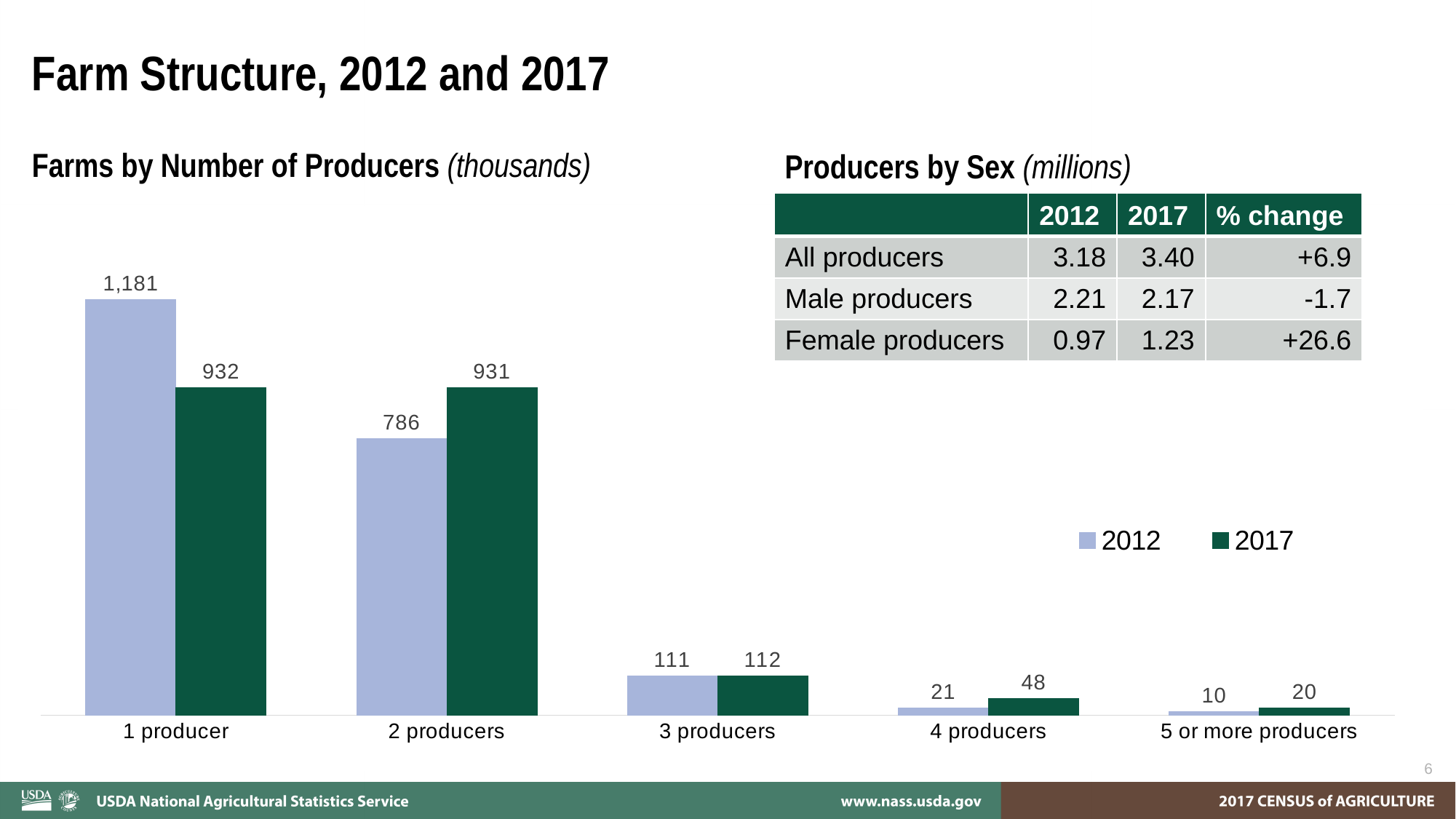
In the Farms by Number of Producers chart, what is the difference between the 2012 and 2017 values for 1 producer? 249 In the Farms by Number of Producers chart, which category has the highest 2012 value? 1 producer In the Farms by Number of Producers chart, what is the 2012 value for 1 producer? 1,181 In the Farms by Number of Producers chart, what is the 2012 value for 5 or more producers? 10 In the Farms by Number of Producers chart, which is larger for 4 producers: the 2012 value or the 2017 value? 2017 What kind of chart is the Farms by Number of Producers chart? Bar chart How many categories are shown on the x axis of the Farms by Number of Producers chart? 5 In the Farms by Number of Producers chart, which category has the lowest 2017 value? 5 or more producers How many series does the legend of the Farms by Number of Producers chart list? 2 In the Farms by Number of Producers chart, what is the 2017 value for 2 producers? 931 In the Farms by Number of Producers chart, what is the difference between the 2017 and 2012 values for 2 producers? 145 In the Farms by Number of Producers chart, what is the 2017 value for 4 producers? 48